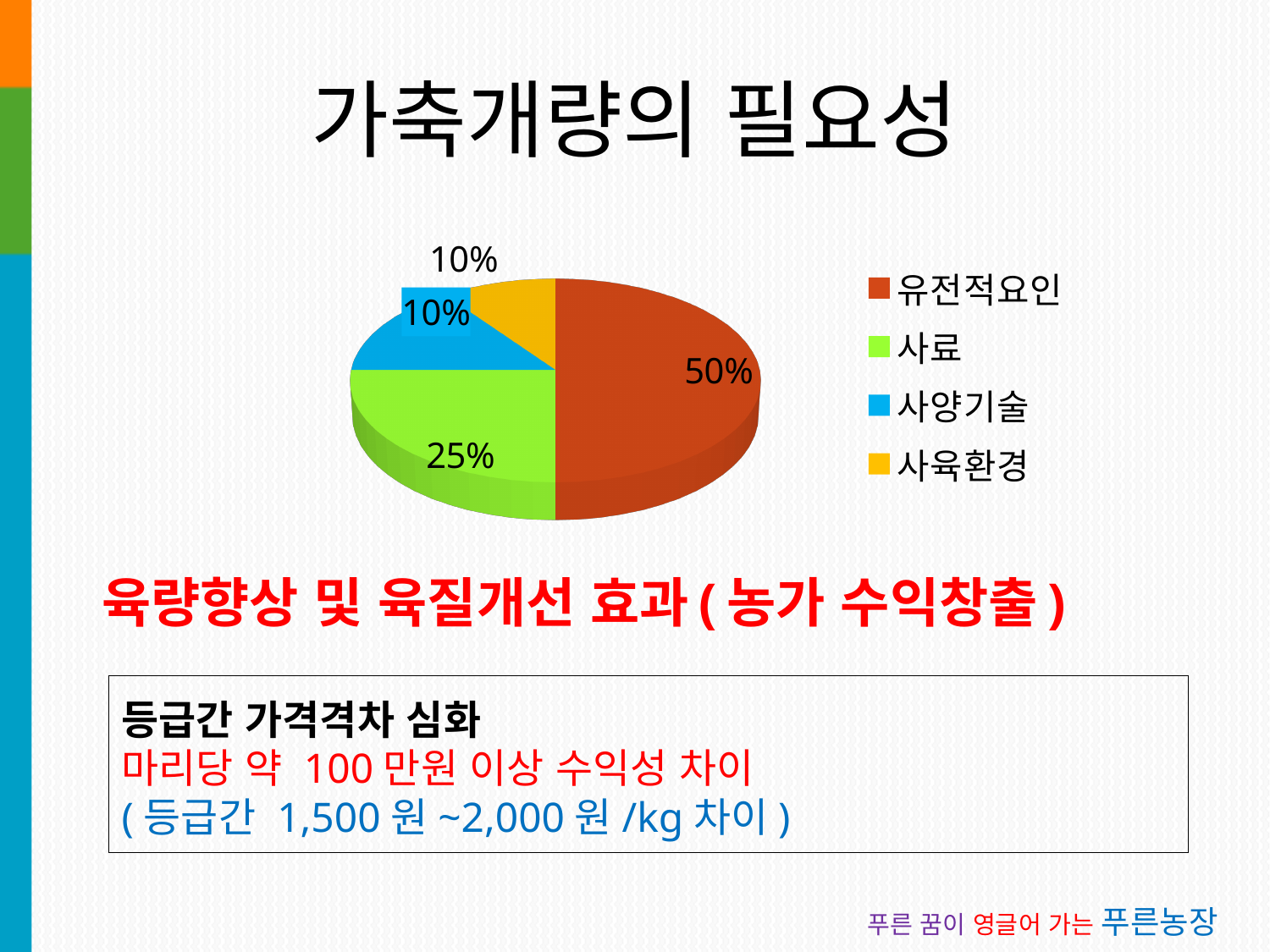
What share of the pie does 유전적요인 account for? 50% How many entries does the legend list? 4 What is the difference in percentage points between 사료 and 사육환경? 15 Which colour represents 사양기술 in the pie chart? blue What share of the pie does 사육환경 account for? 10% What is the difference in percentage points between 유전적요인 and 사료? 25 What share of the pie does 사양기술 account for? 10% What kind of chart is shown on the slide? pie chart Which is larger, the slice for 사료 or the slice for 사양기술? 사료 Which category has the largest slice of the pie? 유전적요인 How many slices does the pie chart have? 4